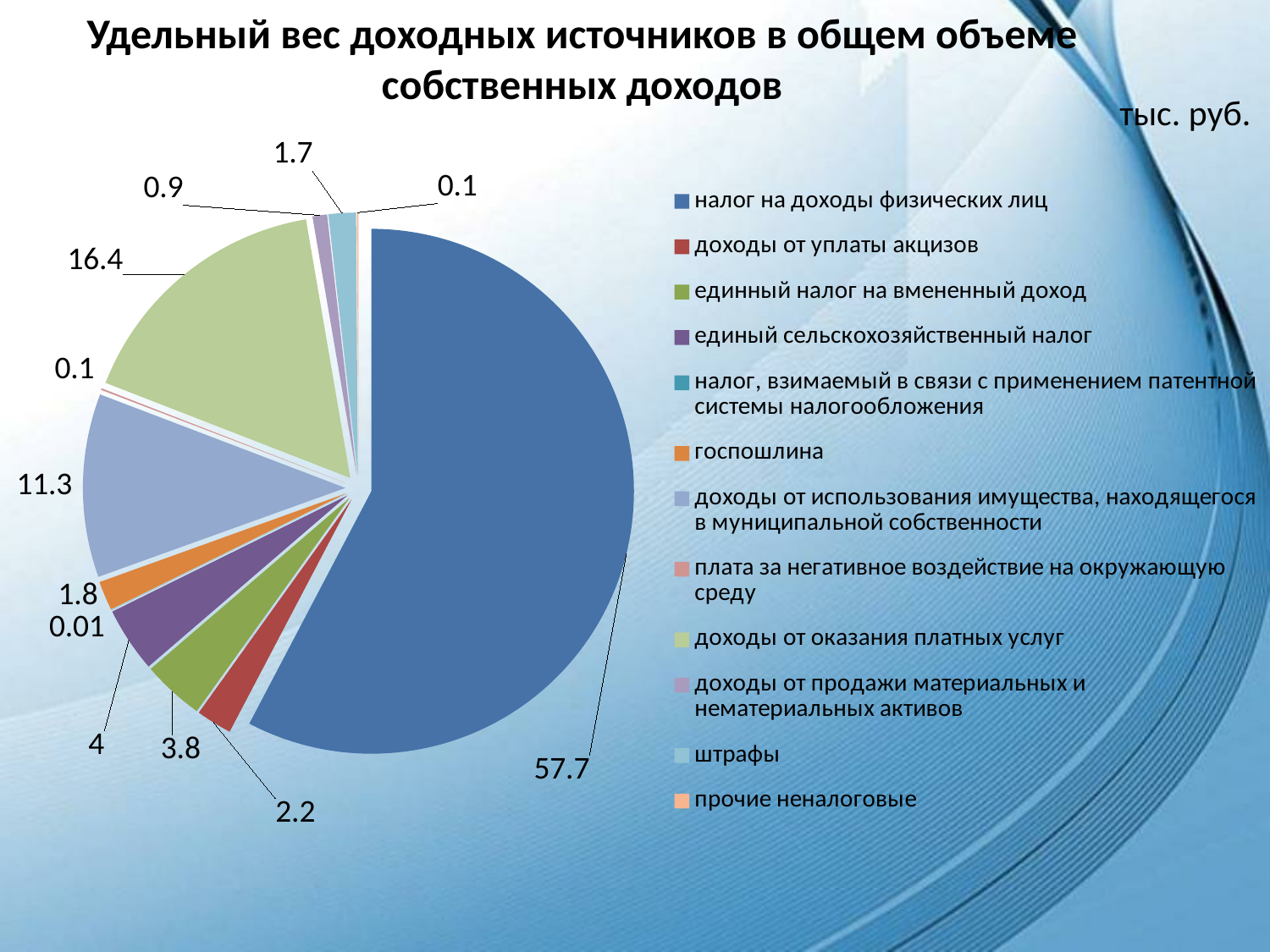
What unit is indicated in the top right corner of the slide? тыс. руб. What is the difference between the values for доходы от оказания платных услуг and доходы от использования имущества, находящегося в муниципальной собственности? 5.1 What is the value shown for доходы от использования имущества, находящегося в муниципальной собственности? 11.3 What is the value shown for доходы от оказания платных услуг? 16.4 What kind of chart is shown on the slide? pie chart How many entries does the legend of the pie chart list? 12 What is the value shown for штрафы? 1.7 Which category has the largest slice of the pie? налог на доходы физических лиц What is the difference between the values for налог на доходы физических лиц and доходы от уплаты акцизов? 55.5 What is the value shown for налог на доходы физических лиц? 57.7 What is the value shown for госпошлина? 1.8 Which is larger: единый сельскохозяйственный налог or единый налог на вмененный доход? единый сельскохозяйственный налог